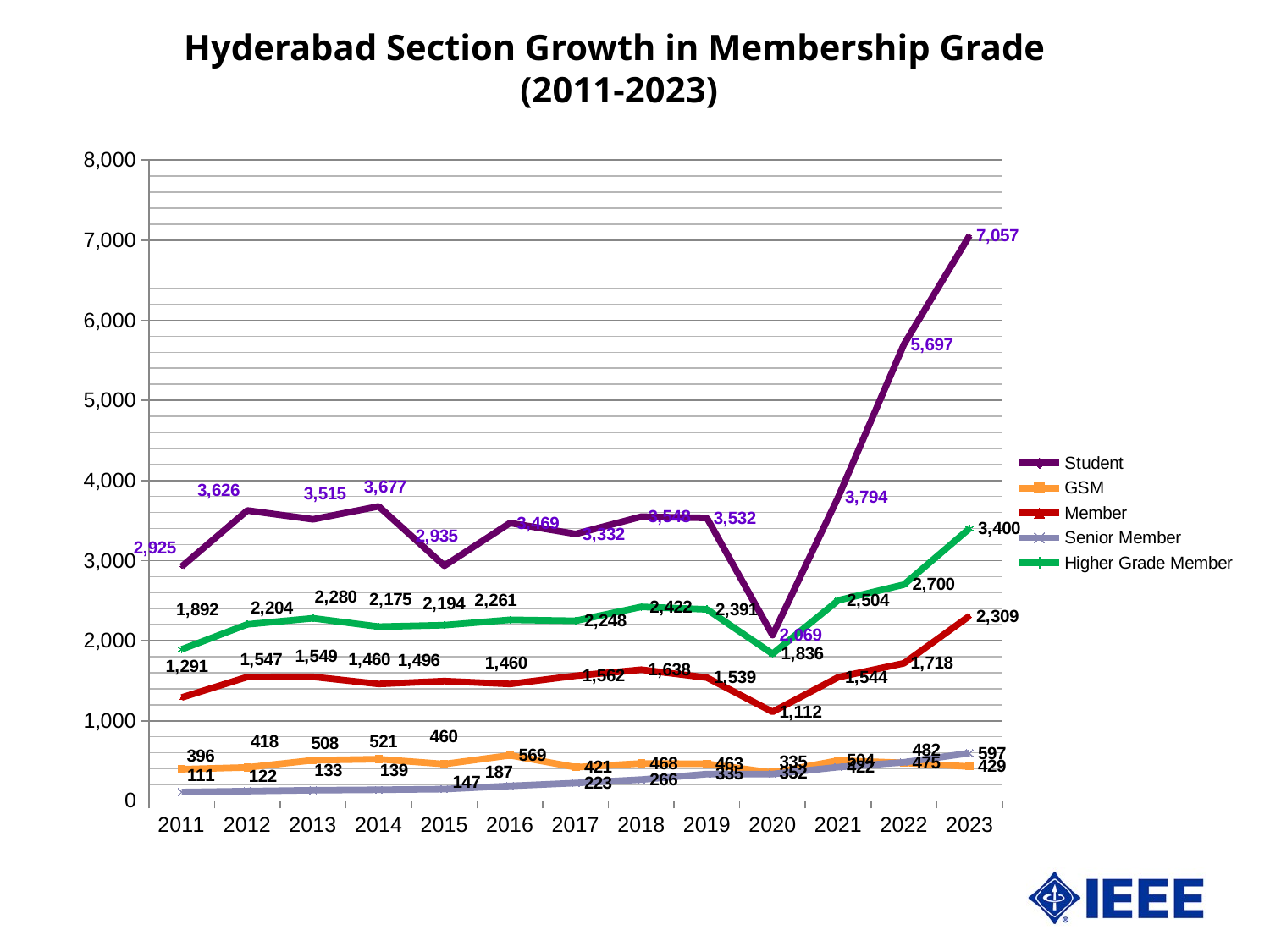
How many years are plotted along the x axis? 13 Does the Senior Member series rise or fall from 2011 to 2023? Rise What is the difference between the Student values for 2023 and 2022? 1,360 In which year is the Student series at its lowest? 2020 What kind of chart is shown on the slide? Line chart What is the Student value for 2023? 7,057 What is the Higher Grade Member value for 2023? 3,400 What is the title of the chart? Hyderabad Section Growth in Membership Grade (2011-2023) What is the Member value for 2020? 1,112 Which is larger in 2023, the Member value or the Higher Grade Member value? Higher Grade Member How many series does the legend list? 5 In which year is the Student series at its highest? 2023